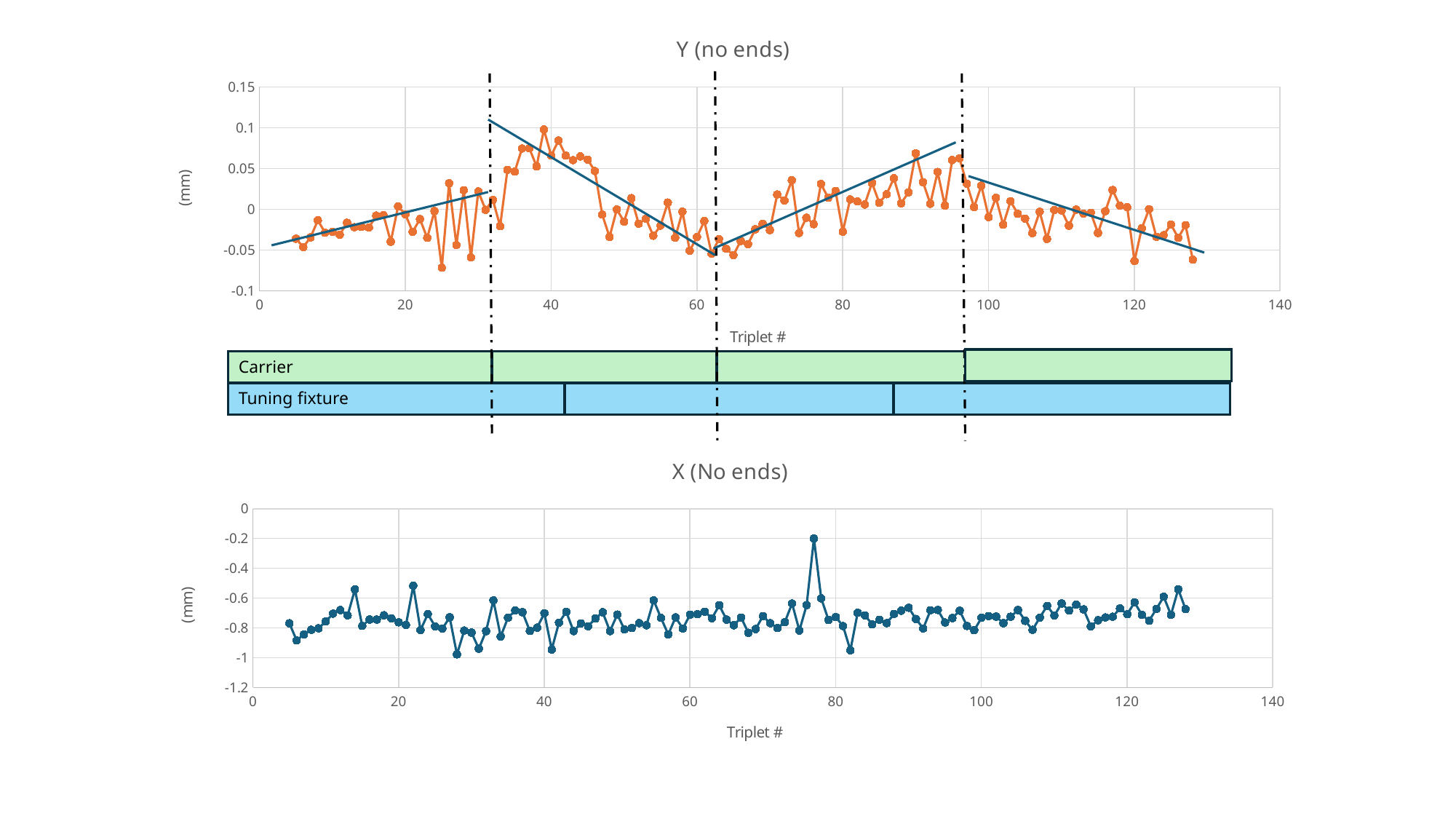
What is the title of the top chart on the slide? Y (no ends) What kind of chart is the "X (No ends)" chart? line chart What is the x-axis label of the "X (No ends)" chart? Triplet # In the "X (No ends)" chart, is the value at triplet 77 larger or smaller than the value at triplet 82? larger In the "Y (no ends)" chart, do the values generally rise or fall between triplet 40 and triplet 60? fall What kind of chart is the "Y (no ends)" chart? line chart In the "Y (no ends)" chart, is the value at triplet 39 larger or smaller than the value at triplet 62? larger In the "X (No ends)" chart, is the value of the highest spike (near triplet 77) greater or less than -0.4? greater In the "Y (no ends)" chart, is the lowest point (near triplet 25) greater or less than -0.05? less In the "Y (no ends)" chart, do the values generally rise or fall between triplet 65 and triplet 95? rise In the "X (No ends)" chart, is the lowest point (near triplet 28) greater or less than -0.8? less